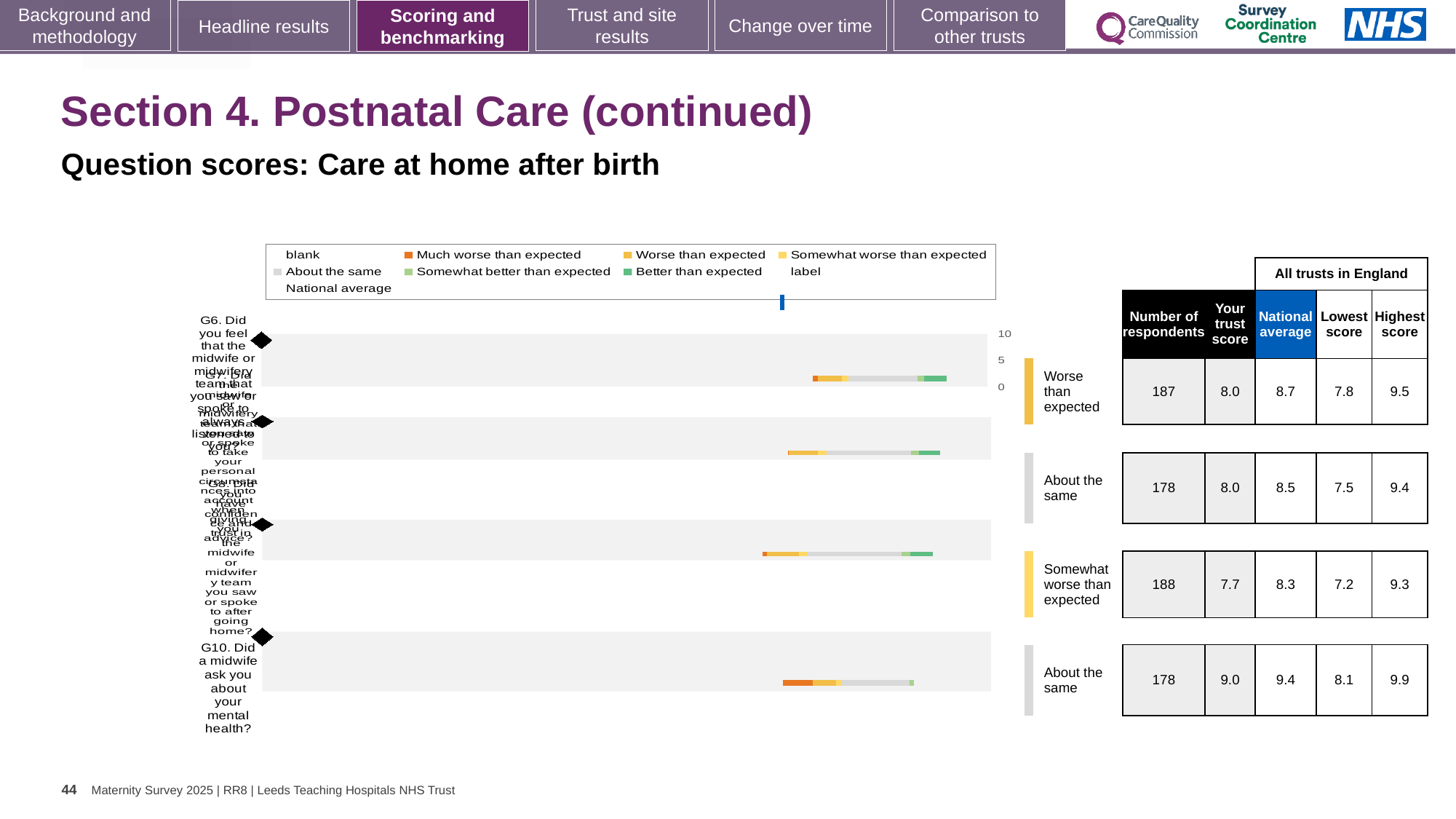
For G10 (the last row), what is the difference between the national average and the trust score? 0.4 How many questions (bars) are plotted in the chart? 4 What is the highest score among all trusts in England for G10 (the last row)? 9.9 How many entries does the chart legend list? 9 Which question has the highest trust score? G10 For G6 (the first row), which is larger: the trust score or the national average? National average What is the lowest trust score shown in the table? 7.7 What is the trust score for G10 (Did a midwife ask you about your mental health?)? 9.0 What kind of chart is shown on the slide? bar chart What benchmark category is shown for G6 (the first row)? Worse than expected What is the number of respondents for G6 (the first row)? 187 What is the national average for G6 (the first row)? 8.7